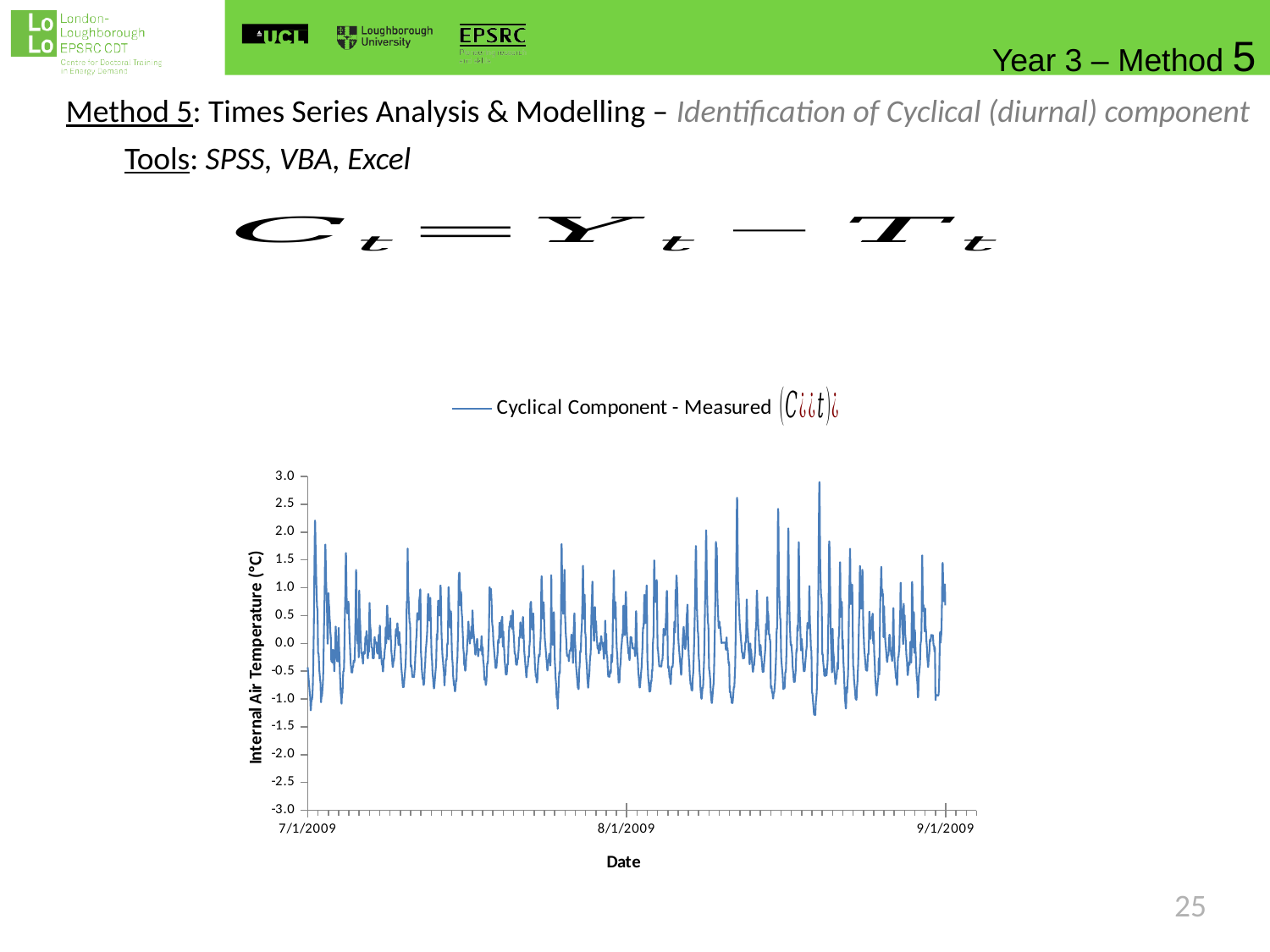
What is the minimum value shown on the vertical axis scale? -3.0 How many series does the chart legend list? 1 What kind of chart is shown on the slide? line chart What is the name of the series shown in the chart legend? Cyclical Component - Measured Is the lowest value of the plotted series greater or less than -2.0? greater What is the last date label shown on the x axis? 9/1/2009 What is the maximum value shown on the vertical axis scale? 3.0 What is the first date label shown on the x axis? 7/1/2009 Is the highest peak of the plotted series greater or less than 3.0? less What is the title of the vertical axis of the chart? Internal Air Temperature (°C) Is the lowest value of the plotted series greater or less than -1.0? less